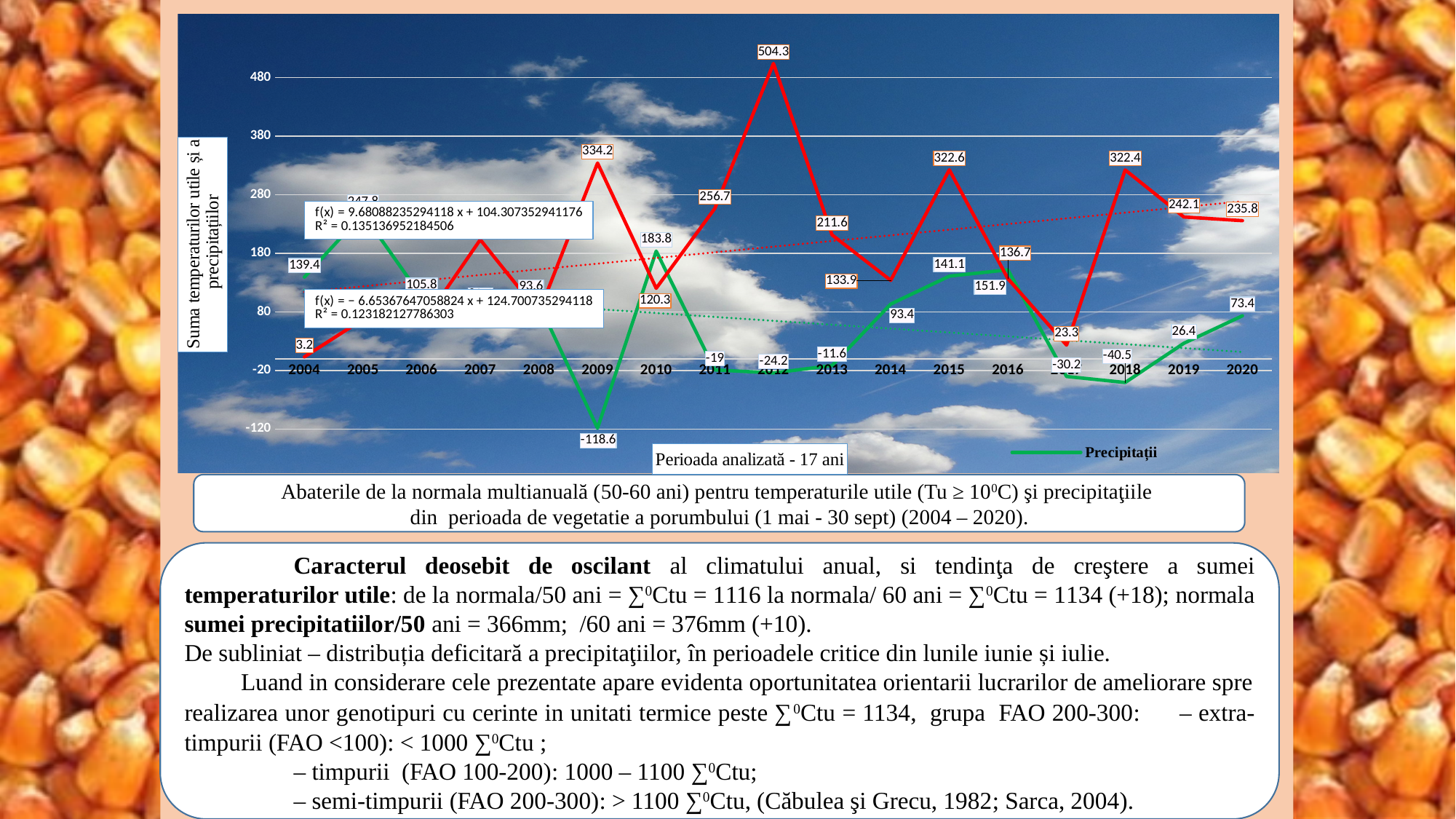
In which year does the green Precipitații line reach its lowest value? 2009 How many years (data points) are plotted along the x axis of the chart? 17 Which is larger: the red line's value in 2012 or in 2015? 2012 In which year does the red line reach its highest value? 2012 What is the value of the red line in 2009? 334.2 Is the value of the green Precipitații line in 2005 greater or less than 180? greater What series name is shown in the chart legend? Precipitații What kind of chart is shown on the slide? line chart What is the value of the green Precipitații line in 2009? -118.6 What is the value of the green Precipitații line in 2020? 73.4 What is the difference between the red line's value in 2012 and its value in 2009? 170.1 What is the value of the red line in 2012? 504.3